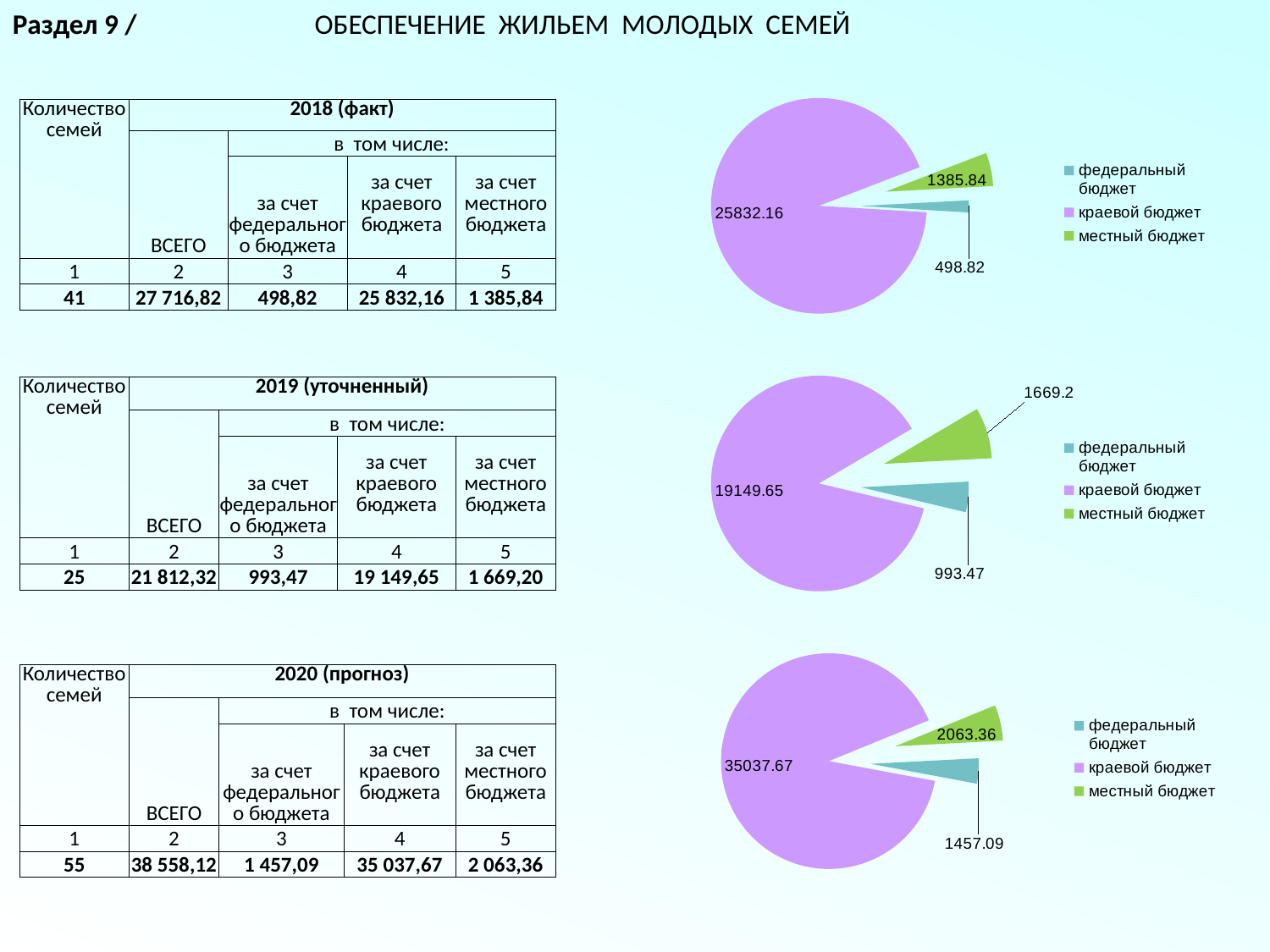
In the bottom pie chart, what is the value of the местный бюджет slice? 2063.36 In the top pie chart, what is the value of the largest slice (краевой бюджет)? 25832.16 How many slices does the bottom pie chart have? 3 In the top pie chart, what share of the whole pie does the местный бюджет slice represent? 5% In the middle pie chart, which is larger: the местный бюджет slice or the федеральный бюджет slice? местный бюджет In the top pie chart, what is the value of the местный бюджет slice? 1385.84 In the middle pie chart, which budget has the smallest slice? федеральный бюджет What kind of chart is the top chart on the right side of the slide? pie chart In the bottom pie chart, which budget has the largest slice? краевой бюджет In the top pie chart, what is the difference between the местный бюджет slice and the федеральный бюджет slice? 887.02 How many entries does the legend of the top pie chart list? 3 In the middle pie chart, what is the value of the федеральный бюджет slice? 993.47